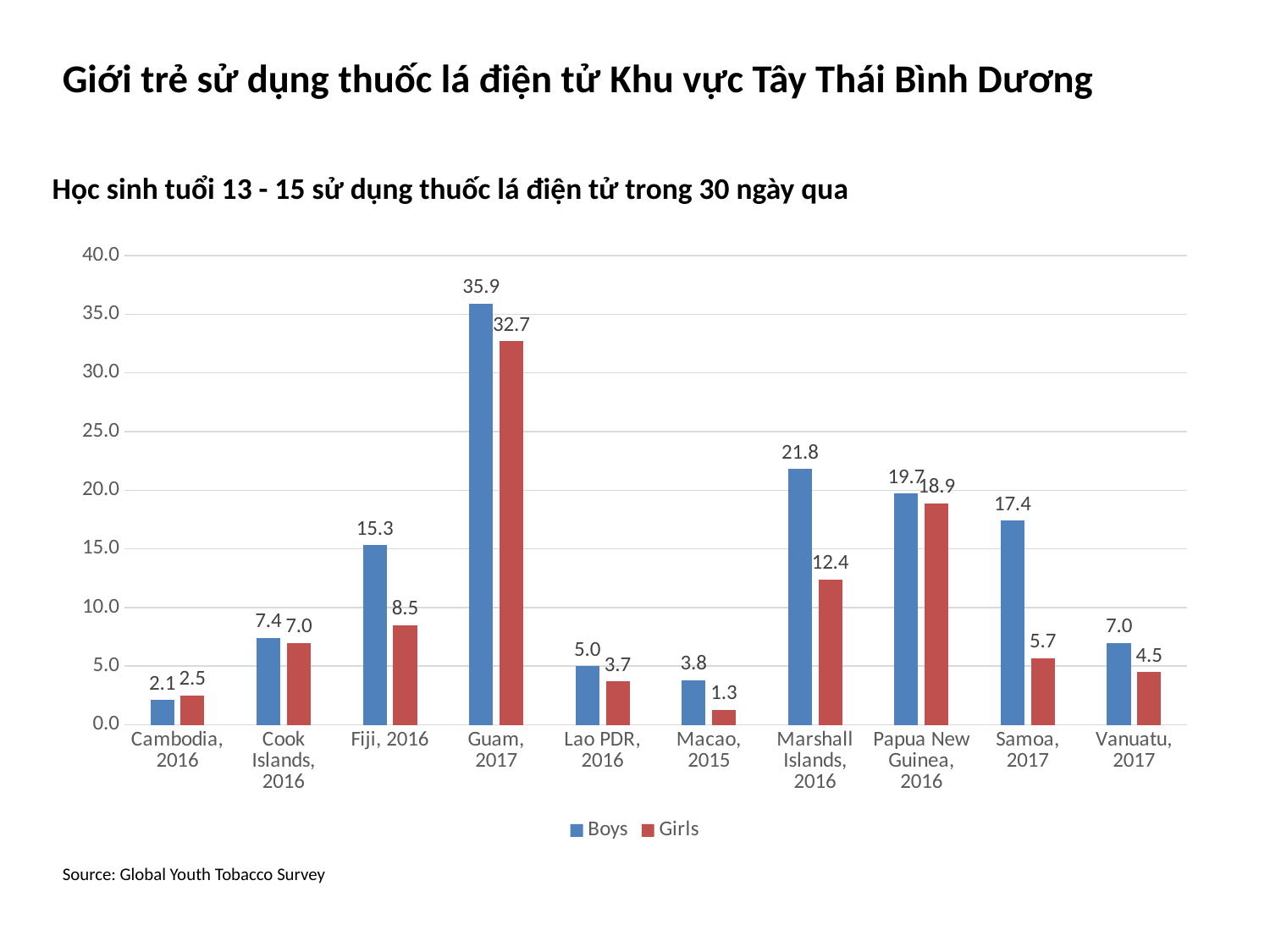
Which category has the lowest value for Girls? Macao, 2015 What is the value for Girls in Marshall Islands, 2016? 12.4 What is the value for Girls in Macao, 2015? 1.3 What colour are the Girls bars? Red Is the value for Boys in Samoa, 2017 greater or less than 15.0? greater What kind of chart is shown on the slide? Bar chart How many series does the legend list? 2 What is the difference between the Boys and Girls values for Marshall Islands, 2016? 9.4 How many categories are shown on the x axis? 10 What is the value for Boys in Guam, 2017? 35.9 Which is larger in Cambodia, 2016: the Boys value or the Girls value? Girls Which category has the highest value for Boys? Guam, 2017